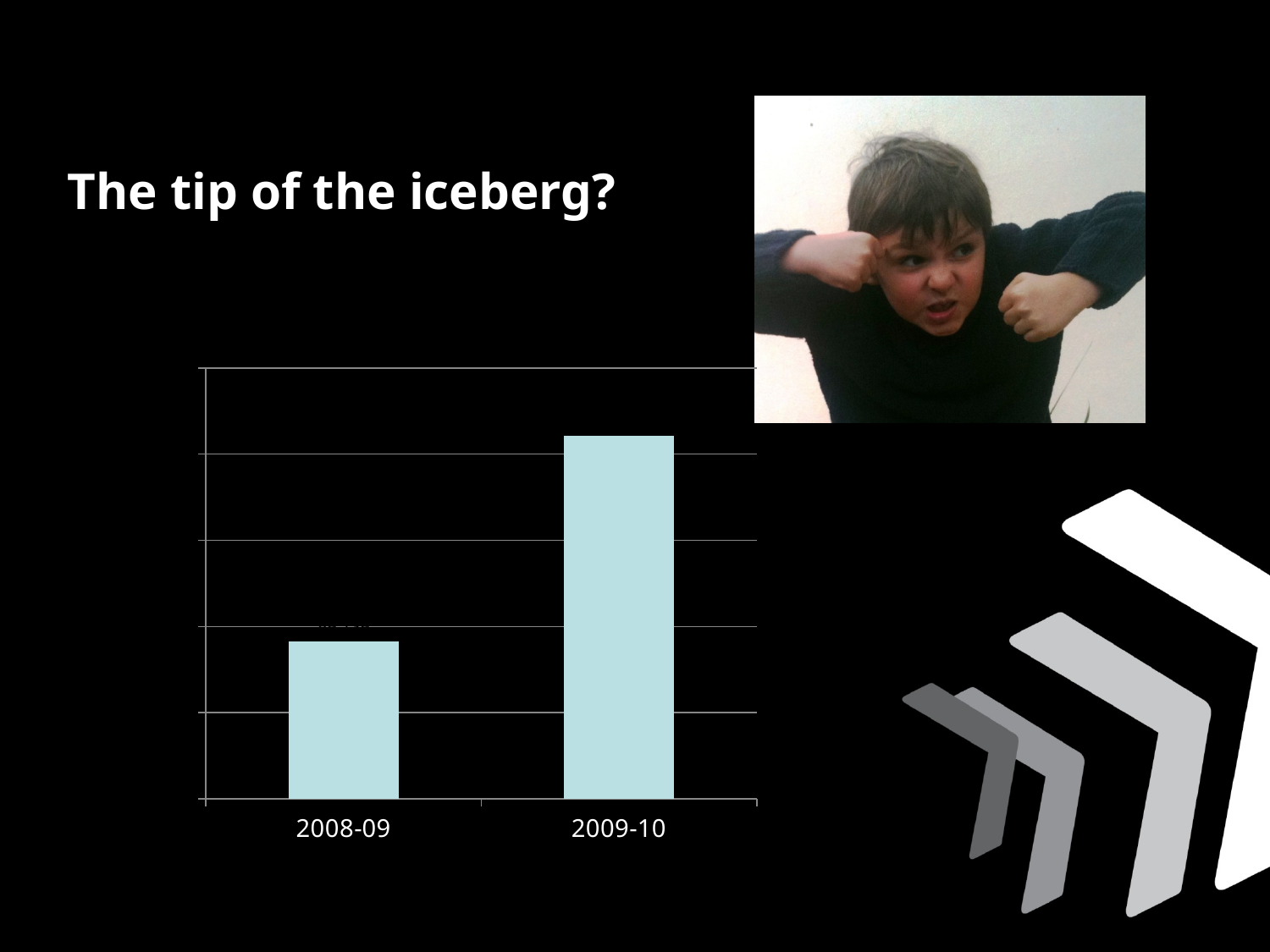
Do the values rise or fall from 2008-09 to 2009-10? rise Which is larger, the bar for 2008-09 or the bar for 2009-10? 2009-10 Which category has the highest bar in the chart? 2009-10 What colour are the bars in the chart? light blue What are the category labels on the x axis of the chart? 2008-09 and 2009-10 What kind of chart is shown on the slide? bar chart Which category has the lowest bar in the chart? 2008-09 How many categories are shown on the x axis of the chart? 2